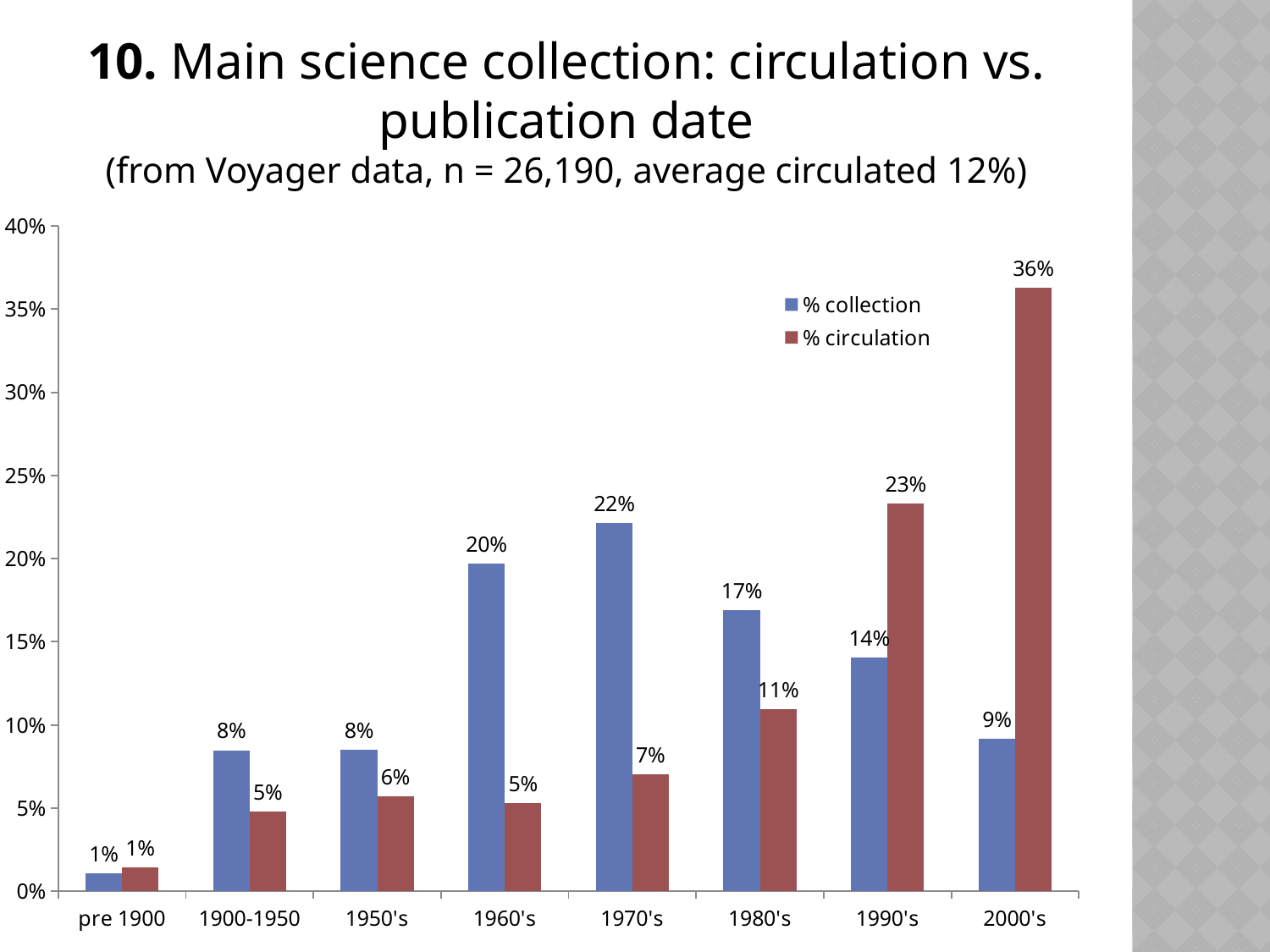
Is the % circulation value for the 2000's greater or less than 35%? greater Which category has the highest % collection value? 1970's What is the % circulation value for the 1980's? 11% What kind of chart is shown on the slide? bar chart What is the % circulation value for the 1990's? 23% How many series does the legend list? 2 What is the % collection value for the 1960's? 20% How many publication date categories are shown on the x axis? 8 Which category has the highest % circulation value? 2000's What is the difference between the % circulation and % collection values for the 2000's? 27% Which category has the lowest % collection value? pre 1900 For the 1970's, which is larger: % collection or % circulation? % collection